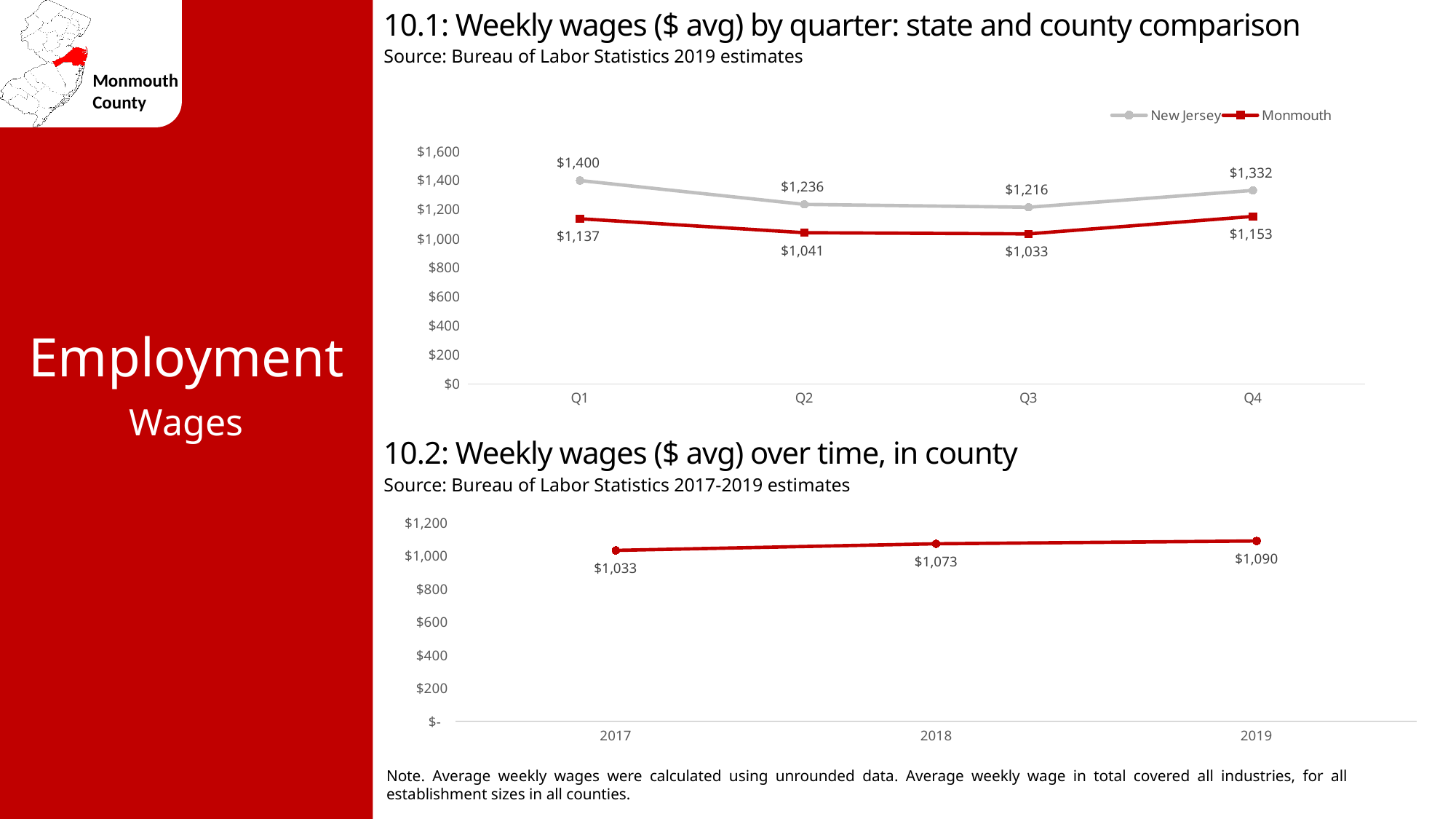
In chart 10.1, what is the difference between the New Jersey and Monmouth weekly wages in Q4? $179 In chart 10.2, do weekly wages rise or fall from 2017 to 2019? Rise In chart 10.1, what is the Monmouth weekly wage in Q3? $1,033 In chart 10.1, what is the New Jersey weekly wage in Q1? $1,400 In chart 10.1, how many series does the legend list? 2 In chart 10.1, which series has the higher value in Q2, New Jersey or Monmouth? New Jersey In chart 10.1, which quarter has the lowest Monmouth weekly wage? Q3 What kind of chart is chart 10.2? Line chart In chart 10.2, what is the weekly wage in 2018? $1,073 In chart 10.1, how many quarters are plotted on the x axis? 4 In chart 10.1, which quarter has the highest New Jersey weekly wage? Q1 In chart 10.2, what is the difference between the 2019 and 2017 weekly wages? $57